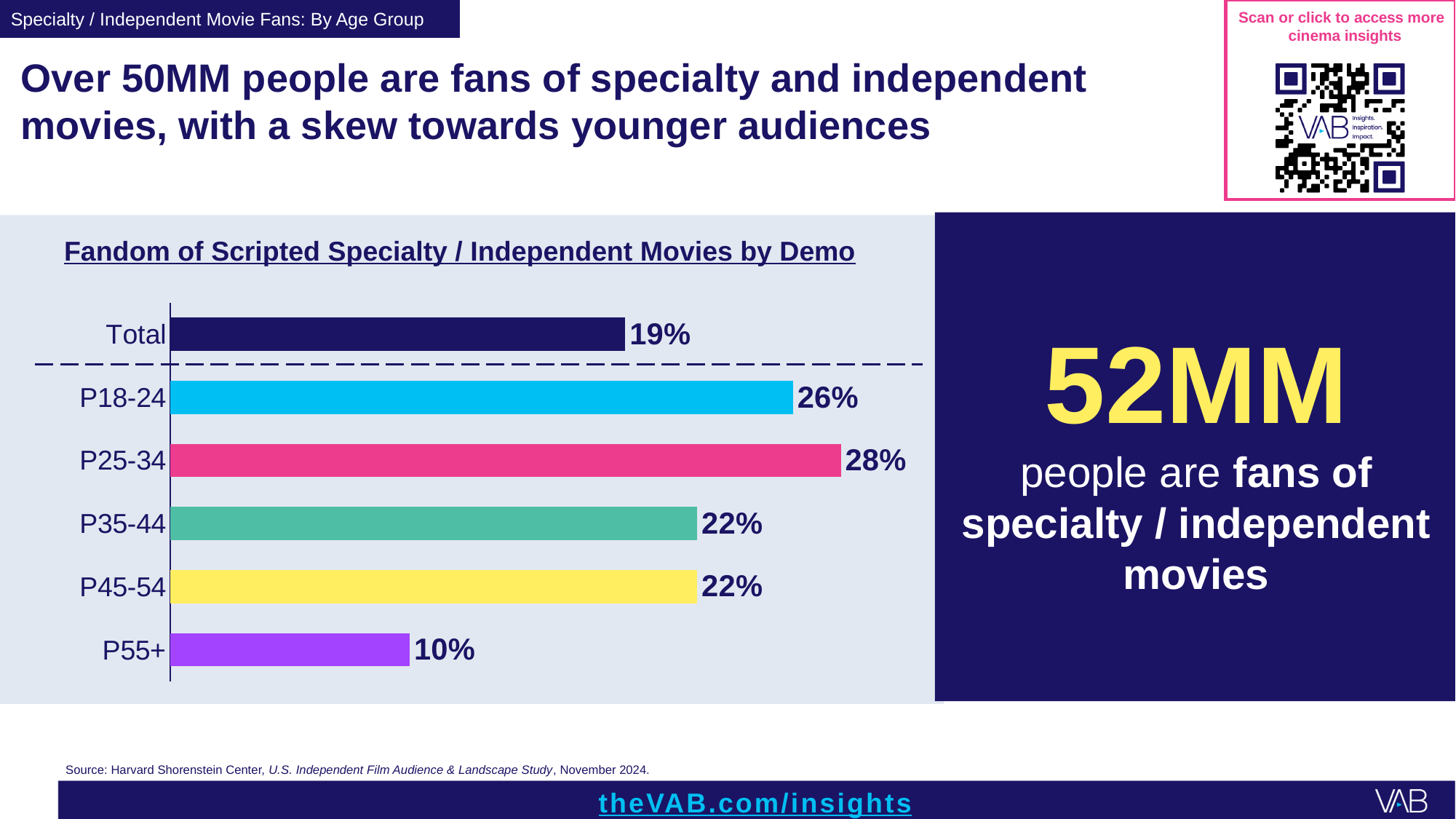
What is the difference between the values for P18-24 and Total? 7% What is the difference between the values for P25-34 and P55+? 18% What is the value for P18-24? 26% Which is larger, the value for P18-24 or the value for P35-44? P18-24 How many bars are plotted in the chart? 6 What is the value for P55+? 10% What is the title of the chart? Fandom of Scripted Specialty / Independent Movies by Demo Which age group has the highest value? P25-34 What is the value for P25-34? 28% What is the value for Total? 19% What kind of chart is shown on the slide? Bar chart Which age group has the lowest value? P55+